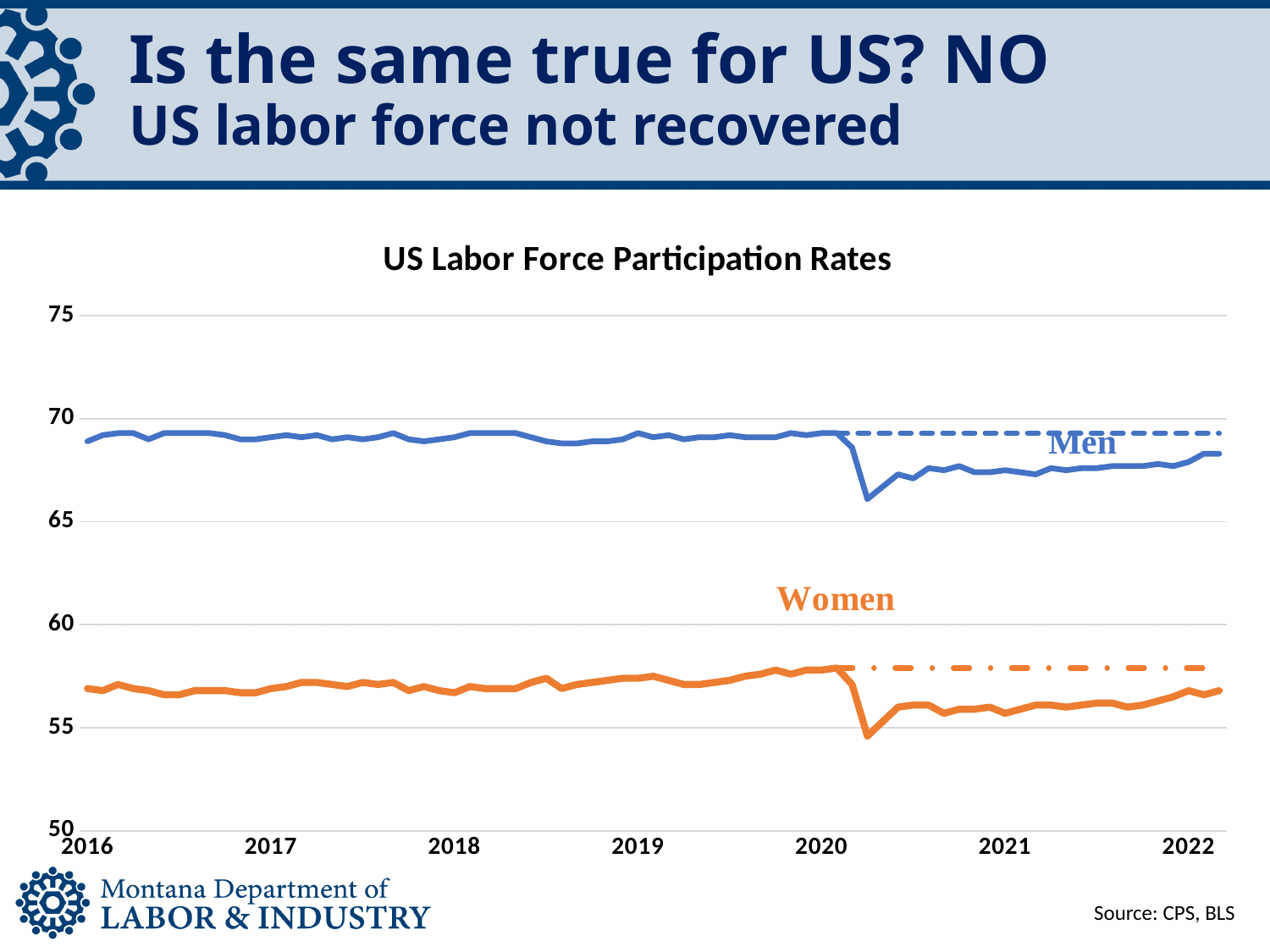
At the end of the chart in 2022, is the Men line above or below the dashed line showing its pre-2020 level? below What colour is the Women line? orange Is the lowest point of the Men line in 2020 greater or less than 65? greater What kind of chart is shown on the slide? line chart Is the value for Women at the start of 2016 greater or less than 60? less Is the value for Men at the start of 2016 greater or less than 65? greater How many series are plotted on the chart? 4 What is the title of the chart? US Labor Force Participation Rates In which year do both the Men and Women lines drop sharply? 2020 Which series has the higher labor force participation rate throughout the chart, Men or Women? Men